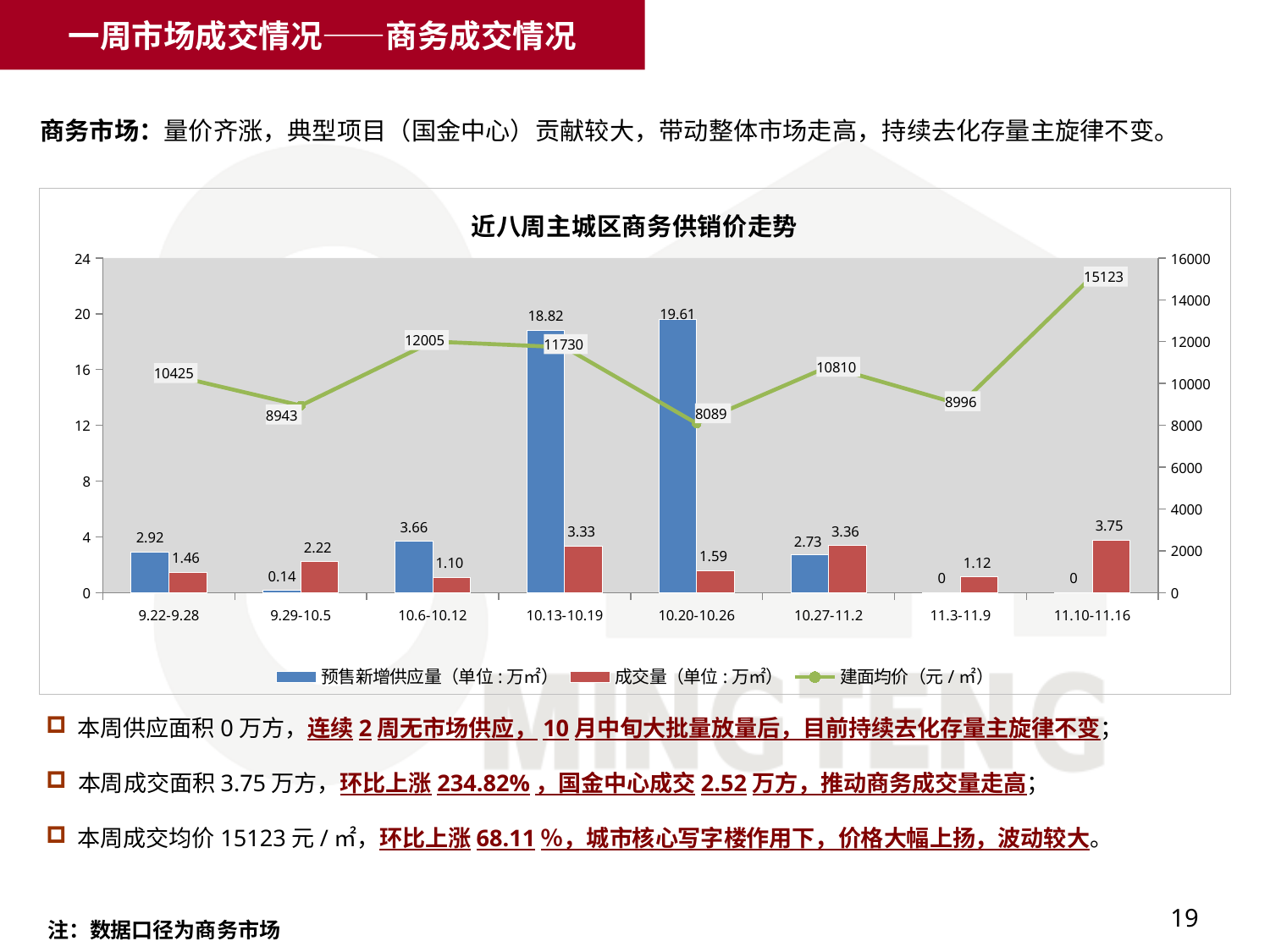
What is the 成交量 value for the week 11.10-11.16? 3.75 What is the 建面均价 value for the week 10.6-10.12? 12005 What is the difference between the 预售新增供应量 values for 10.20-10.26 and 10.13-10.19? 0.79 Which week has the lowest 建面均价? 10.20-10.26 What is the 预售新增供应量 value for the week 10.20-10.26? 19.61 What is the title of the chart? 近八周主城区商务供销价走势 Which week has the highest 成交量? 11.10-11.16 What kind of chart is this? Combined bar and line chart Which week has the highest 建面均价? 11.10-11.16 How many series does the legend list? 3 How many weeks are shown on the x axis? 8 Which is larger, the 成交量 for 9.29-10.5 or for 10.6-10.12? 9.29-10.5